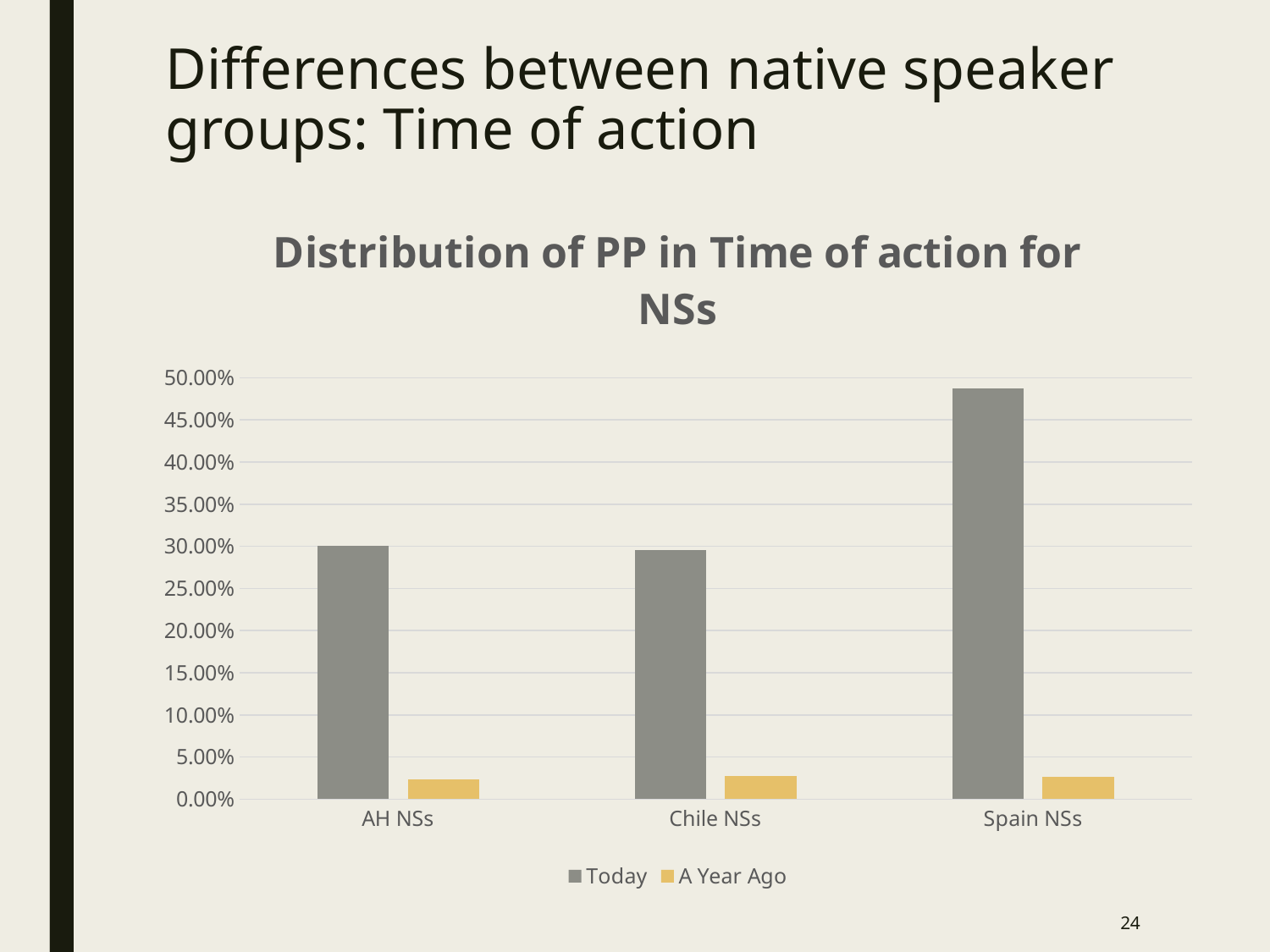
Which group has the highest value for Today? Spain NSs What kind of chart is shown on the slide? bar chart Is the value for Chile NSs in the Today series greater or less than 35.00%? less What is the title of the chart? Distribution of PP in Time of action for NSs Which series is shown in gold/yellow bars? A Year Ago Which group has a larger Today value: AH NSs or Spain NSs? Spain NSs Is the value for AH NSs in the Today series greater or less than 25.00%? greater How many series does the legend list? 2 Is the value for Chile NSs in the A Year Ago series greater or less than 5.00%? less Which is larger for Spain NSs: the Today value or the A Year Ago value? Today How many native speaker groups are shown on the x axis? 3